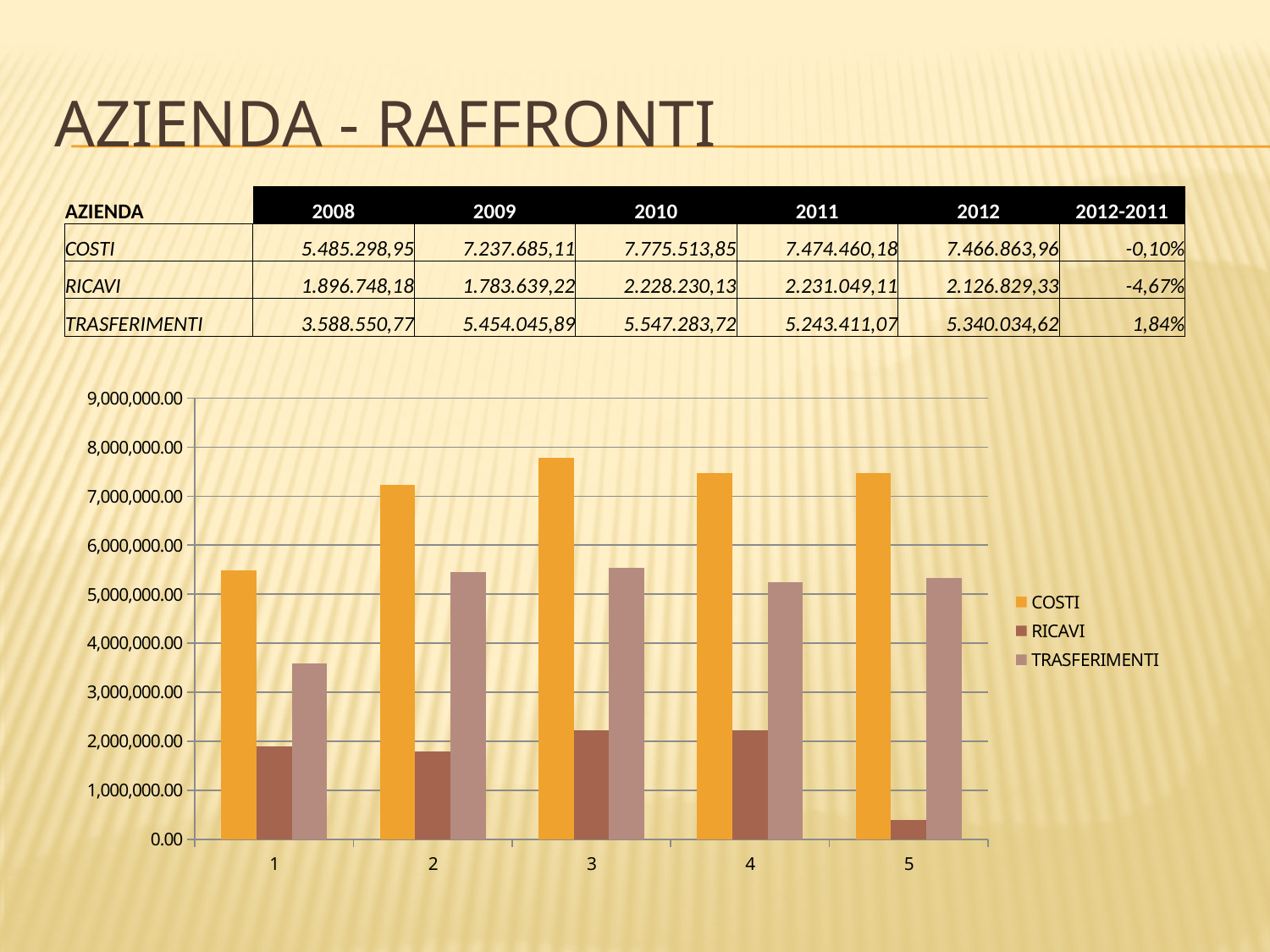
For category 2, which is larger: COSTI or TRASFERIMENTI? COSTI For which category is the COSTI bar highest? 3 How many categories are shown along the x axis of the chart? 5 Is the COSTI value for category 5 greater or less than 7,000,000.00? greater Do the COSTI values rise or fall from category 1 to category 3? rise For which category is the RICAVI bar lowest? 5 Which series are listed in the chart legend? COSTI, RICAVI, TRASFERIMENTI Is the TRASFERIMENTI value for category 1 greater or less than 4,000,000.00? less How many series does the chart legend list? 3 Is the COSTI value for category 1 greater or less than 6,000,000.00? less For which category is the COSTI bar lowest? 1 What kind of chart is shown on the slide? bar chart